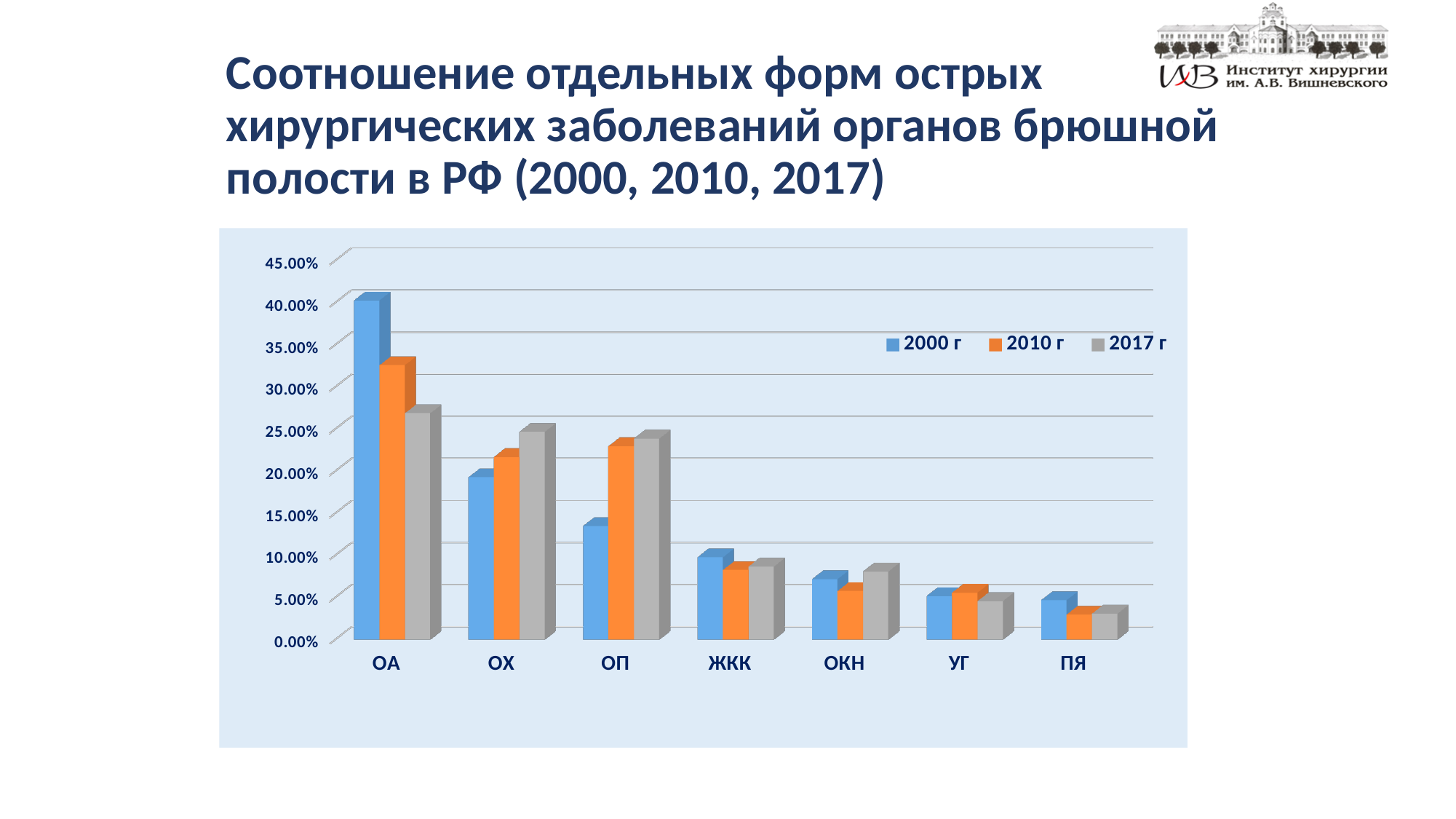
How many series does the chart's legend list? 3 For ОП, which series has the larger value: 2000 г or 2010 г? 2010 г What kind of chart is shown on the slide? bar chart Which category has the lowest value for the 2017 г series? ПЯ What are the three entries listed in the chart's legend? 2000 г, 2010 г, 2017 г How many categories are shown along the x axis of the chart? 7 For ОА, do the values rise or fall from the 2000 г series to the 2017 г series? fall Which category has the highest value for the 2000 г series? ОА Is the value for ОА in the 2000 г series greater or less than 35.00%? greater Is the value for ОП in the 2000 г series greater or less than 15.00%? less For ОА, which series has the larger value: 2000 г or 2017 г? 2000 г Is the value for ОХ in the 2017 г series greater or less than 20.00%? greater